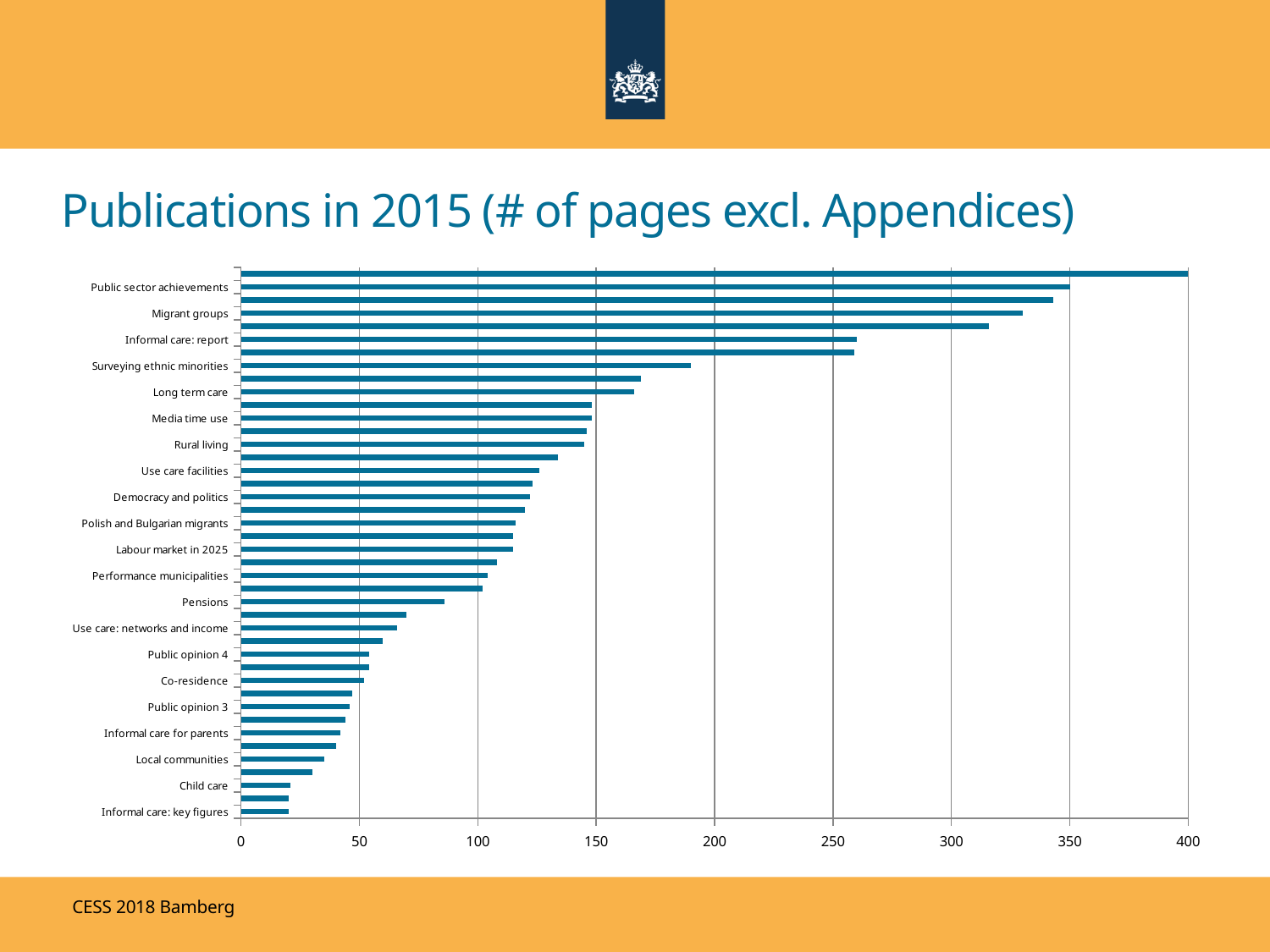
Is the value for Child care greater or less than 50? less Which has the larger value, Migrant groups or Child care? Migrant groups Is the value for Long term care greater or less than 150? greater Is the value for Informal care: report greater or less than 200? greater Do the bar lengths increase or decrease going from the top of the chart to the bottom? decrease What is the title of the chart? Publications in 2015 (# of pages excl. Appendices) Which has the larger value, Long term care or Pensions? Long term care What kind of chart is shown on the slide? bar chart